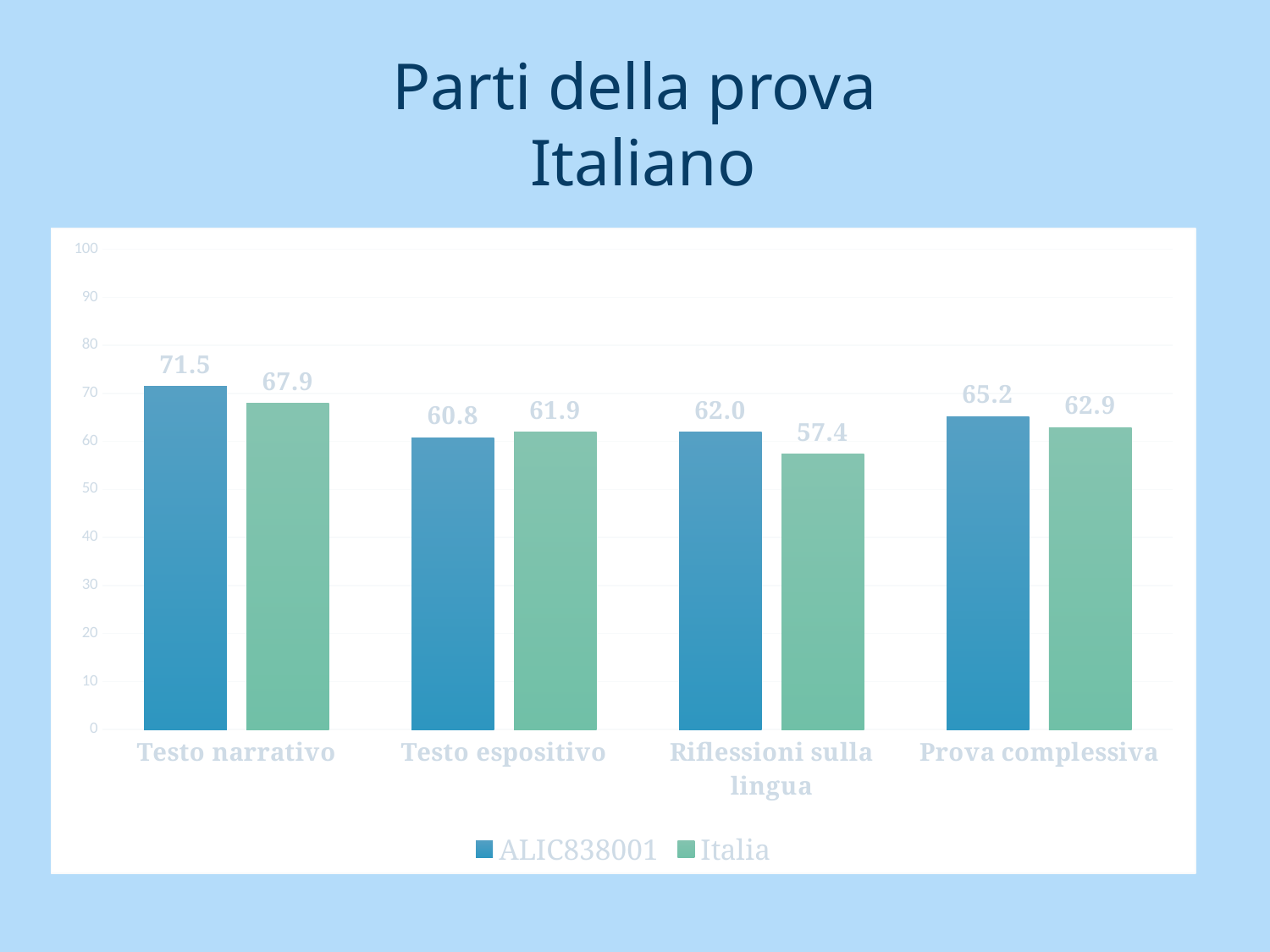
Which category has the lowest value for Italia? Riflessioni sulla lingua What is the difference between ALIC838001 and Italia in Testo narrativo? 3.6 What is the value for Italia in Riflessioni sulla lingua? 57.4 Which category has the highest value for ALIC838001? Testo narrativo What kind of chart is shown on the slide? bar chart What is the value for ALIC838001 in Testo narrativo? 71.5 In Riflessioni sulla lingua, which series has the larger value, ALIC838001 or Italia? ALIC838001 How many categories are shown on the x axis? 4 What is the value for Italia in Prova complessiva? 62.9 Is the value for ALIC838001 in Prova complessiva greater or less than 60? greater What is the difference between Italia and ALIC838001 in Testo espositivo? 1.1 How many series does the legend list? 2